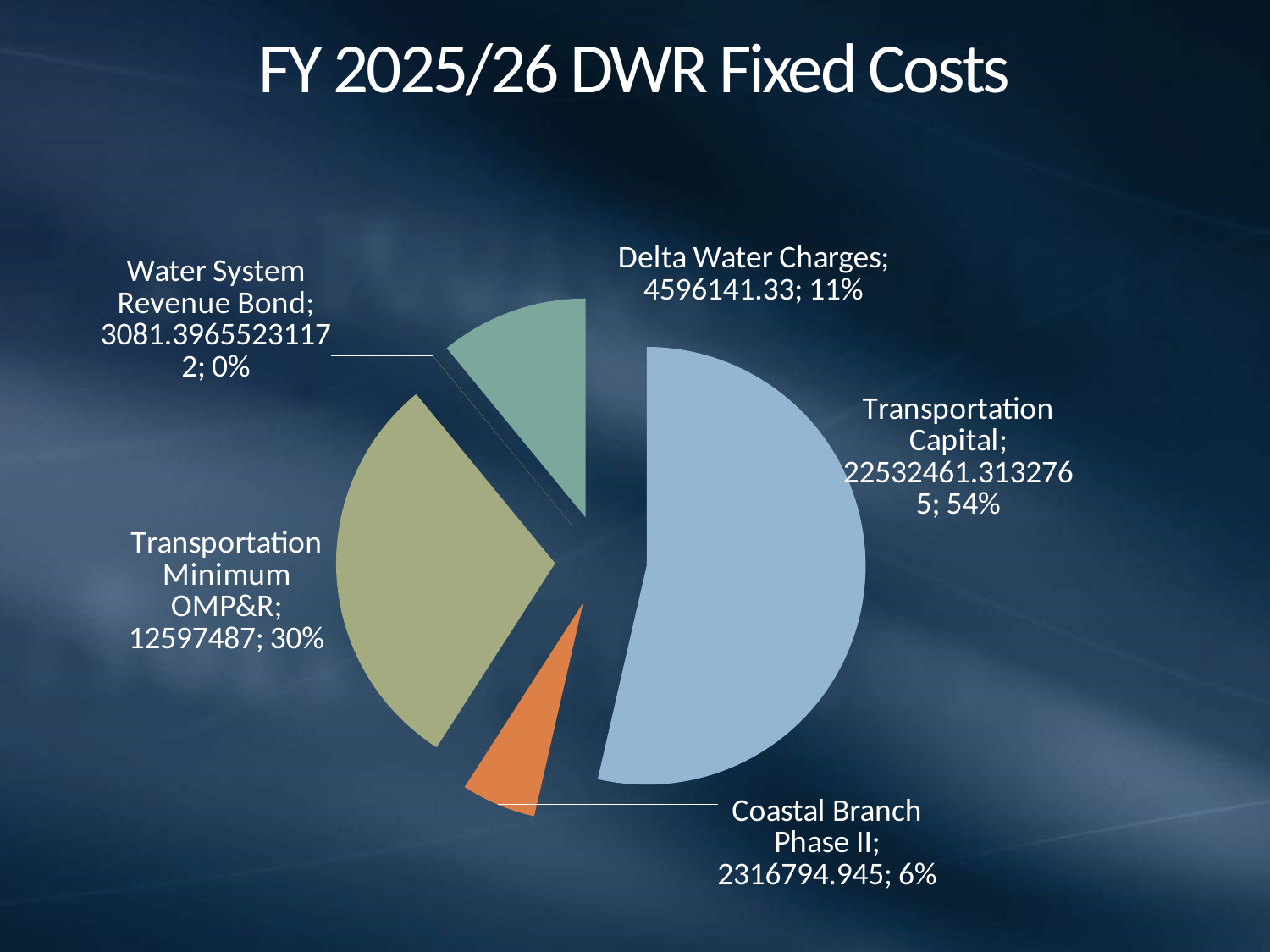
Which is larger, Delta Water Charges or Coastal Branch Phase II? Delta Water Charges What is the value for Transportation Minimum OMP&R? 12597487 Which category has the smallest share of the pie? Water System Revenue Bond What type of chart is shown on the slide? pie chart How many slices does the pie chart have? 5 Which category has the largest share of the pie? Transportation Capital What percentage share does Transportation Minimum OMP&R have? 30% What is the difference between the values for Transportation Minimum OMP&R and Delta Water Charges? 8001345.67 What is the value for Coastal Branch Phase II? 2316794.945 What is the title of the chart? FY 2025/26 DWR Fixed Costs What percentage share does Transportation Capital have? 54% What is the value for Delta Water Charges? 4596141.33